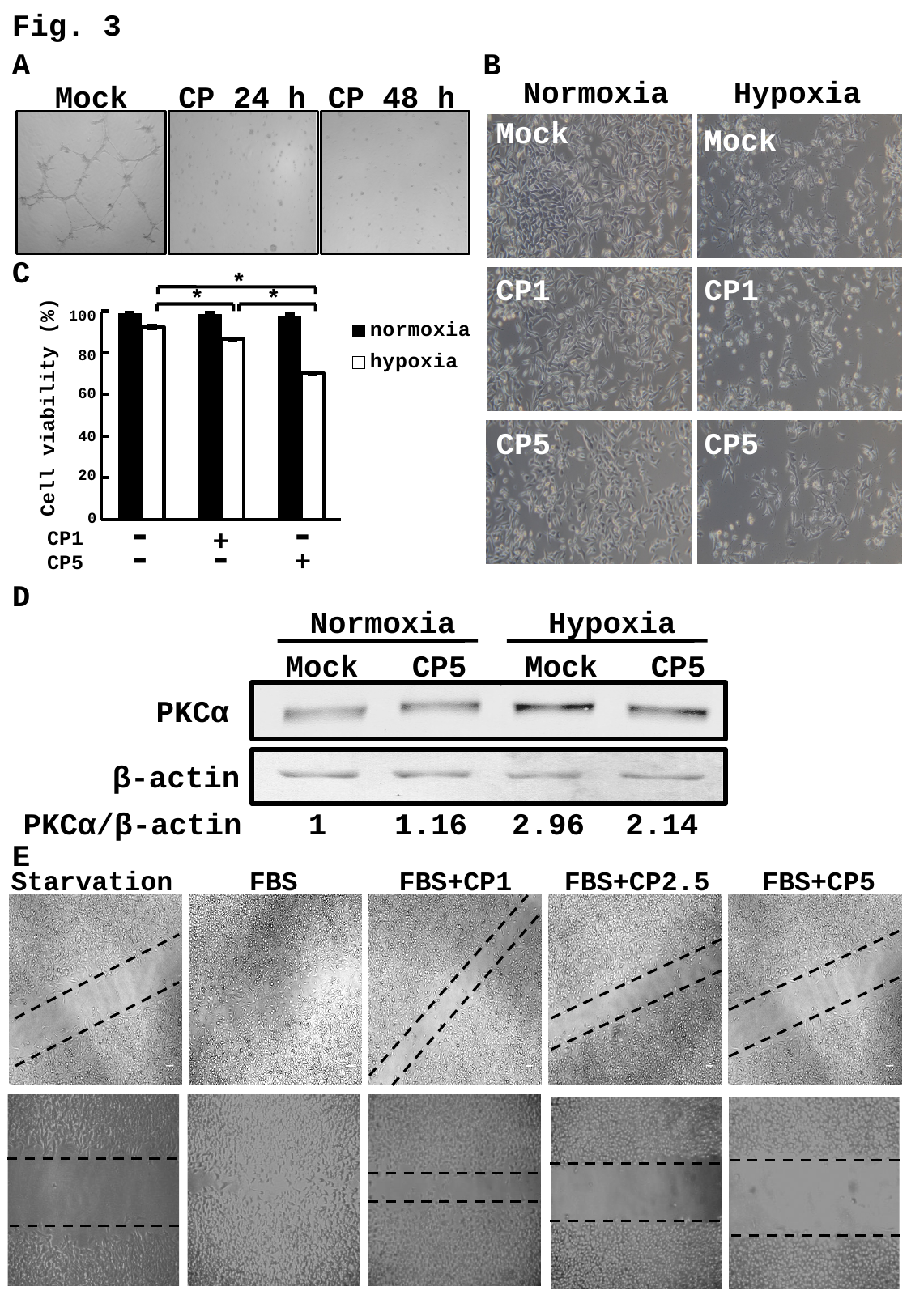
In panel C, is the normoxia value for the CP5 + group greater or less than 80? greater In panel C, what are the two series named in the legend? normoxia and hypoxia In panel C, what kind of chart is shown? bar chart In panel C, what is the label of the y axis? Cell viability (%) In panel C, is the hypoxia value for the CP5 + group greater or less than 80? less In panel C, is the hypoxia value for the CP1 + group greater or less than 60? greater In panel C, which treatment group has the lowest hypoxia cell viability? CP5 + In panel C, for the CP5 + group, which is larger: the normoxia bar or the hypoxia bar? normoxia In panel C, how many series does the legend list? 2 In panel C, do the hypoxia bars rise or fall from the untreated group to the CP5 + group? fall In panel C, how many treatment groups (pairs of bars) are plotted along the x axis? 3